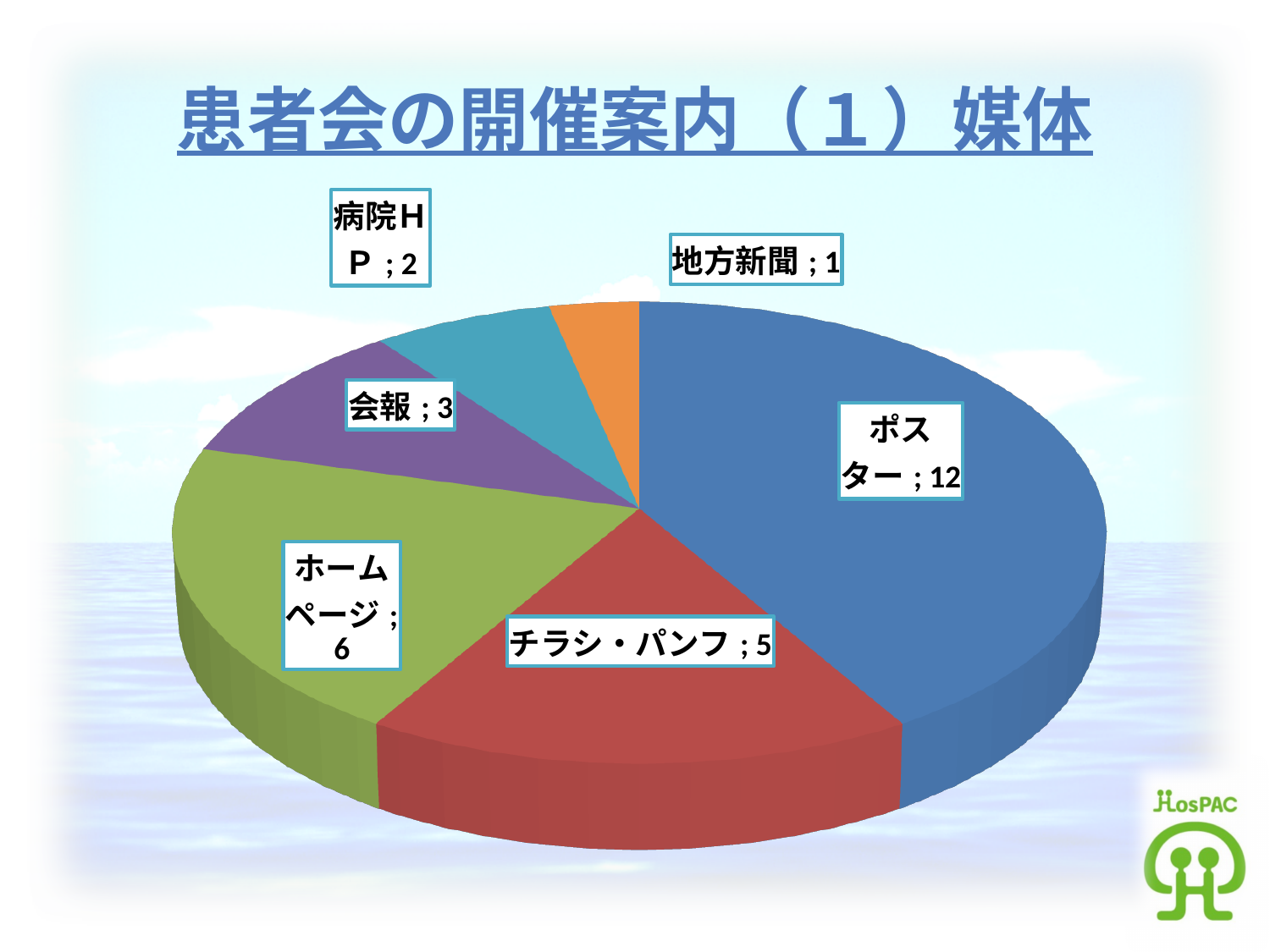
How many slices (categories) does the pie chart have? 6 What is the title of the chart on the slide? 患者会の開催案内（１）媒体 What is the value for チラシ・パンフ? 5 What is the value for 会報? 3 Which category has the smallest slice of the pie? 地方新聞 Which is larger, the value for ホームページ or the value for チラシ・パンフ? ホームページ Which category has the largest slice of the pie? ポスター What kind of chart is shown on the slide? Pie chart What is the value for ホームページ? 6 What is the value for ポスター? 12 What is the value for 地方新聞? 1 What is the difference between the values for ポスター and ホームページ? 6